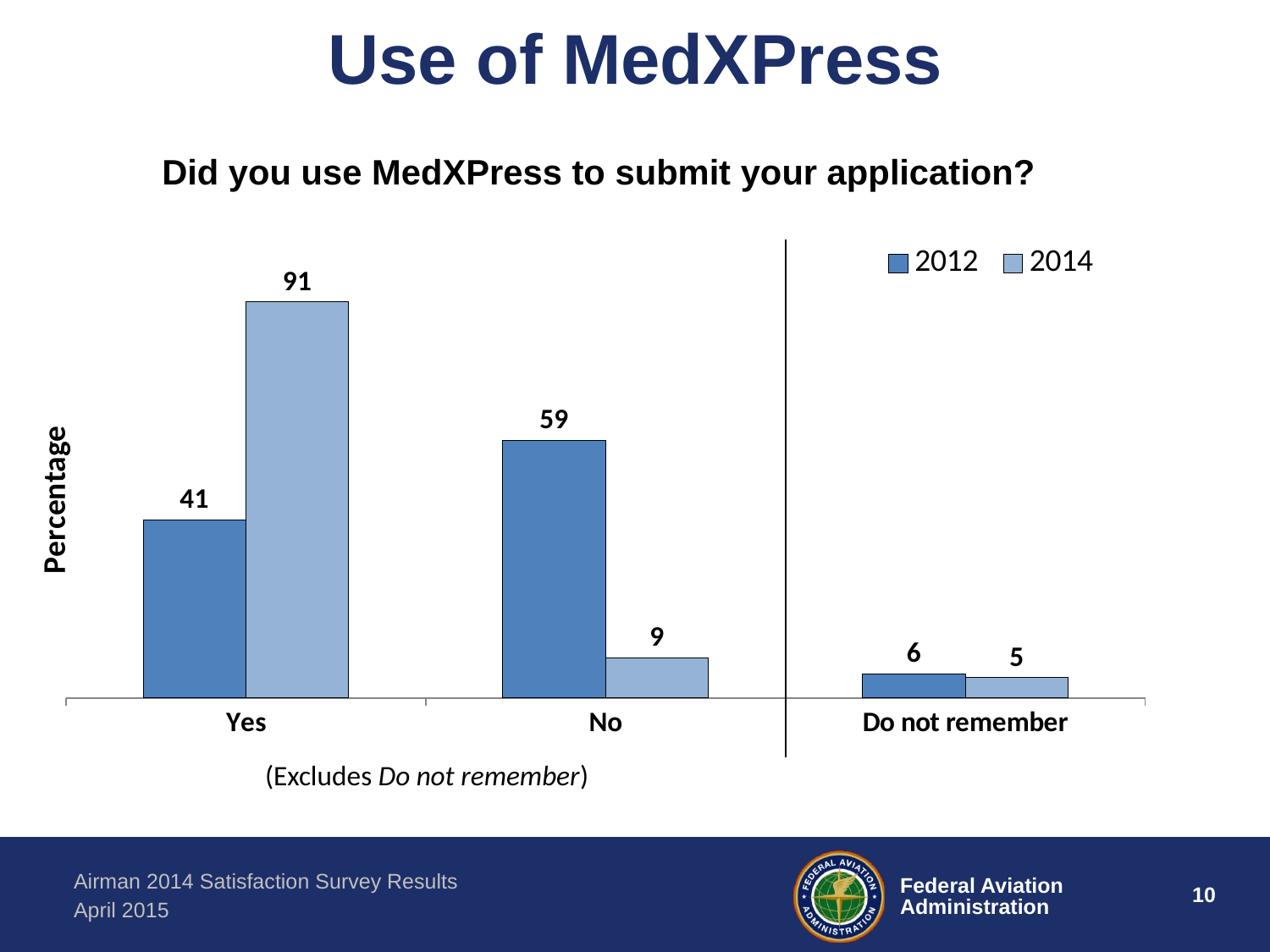
What is the label of the y axis? Percentage What is the value for 2014 in the No category? 9 What is the value for 2012 in the No category? 59 How many series does the legend list? 2 Which category has the lowest value for the 2012 series? Do not remember What is the value for 2014 in the Yes category? 91 What is the difference between the 2014 and 2012 values in the Yes category? 50 What kind of chart is shown on the slide? Bar chart How many categories are shown on the x axis? 3 Which is larger: the 2012 value for Yes or the 2012 value for No? No Which category has the highest value for the 2014 series? Yes What is the value for 2012 in the Do not remember category? 6